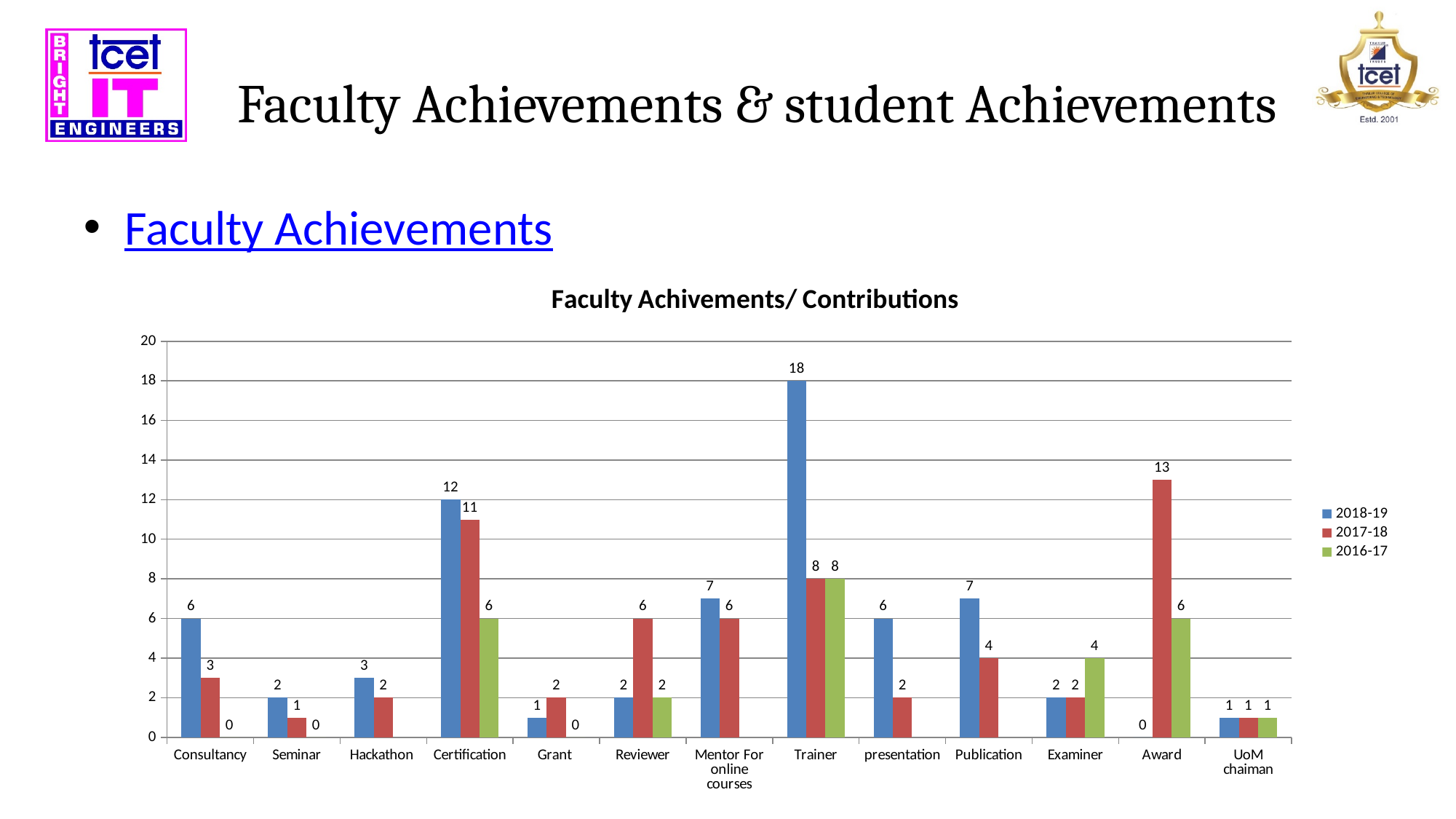
Which is larger for Reviewer: the 2018-19 value or the 2017-18 value? 2017-18 What type of chart is shown on the slide? bar chart Which category has the highest 2017-18 value? Award What is the 2018-19 value for Award? 0 Which category has the highest 2018-19 value? Trainer What is the title of the chart? Faculty Achivements/ Contributions What is the difference between the 2018-19 and 2017-18 values for Certification? 1 How many categories are shown on the x axis of the Faculty Achivements/ Contributions chart? 13 What is the 2016-17 value for Certification? 6 What is the 2018-19 value for Trainer? 18 What is the 2017-18 value for Award? 13 How many series does the legend list in the Faculty Achivements/ Contributions chart? 3